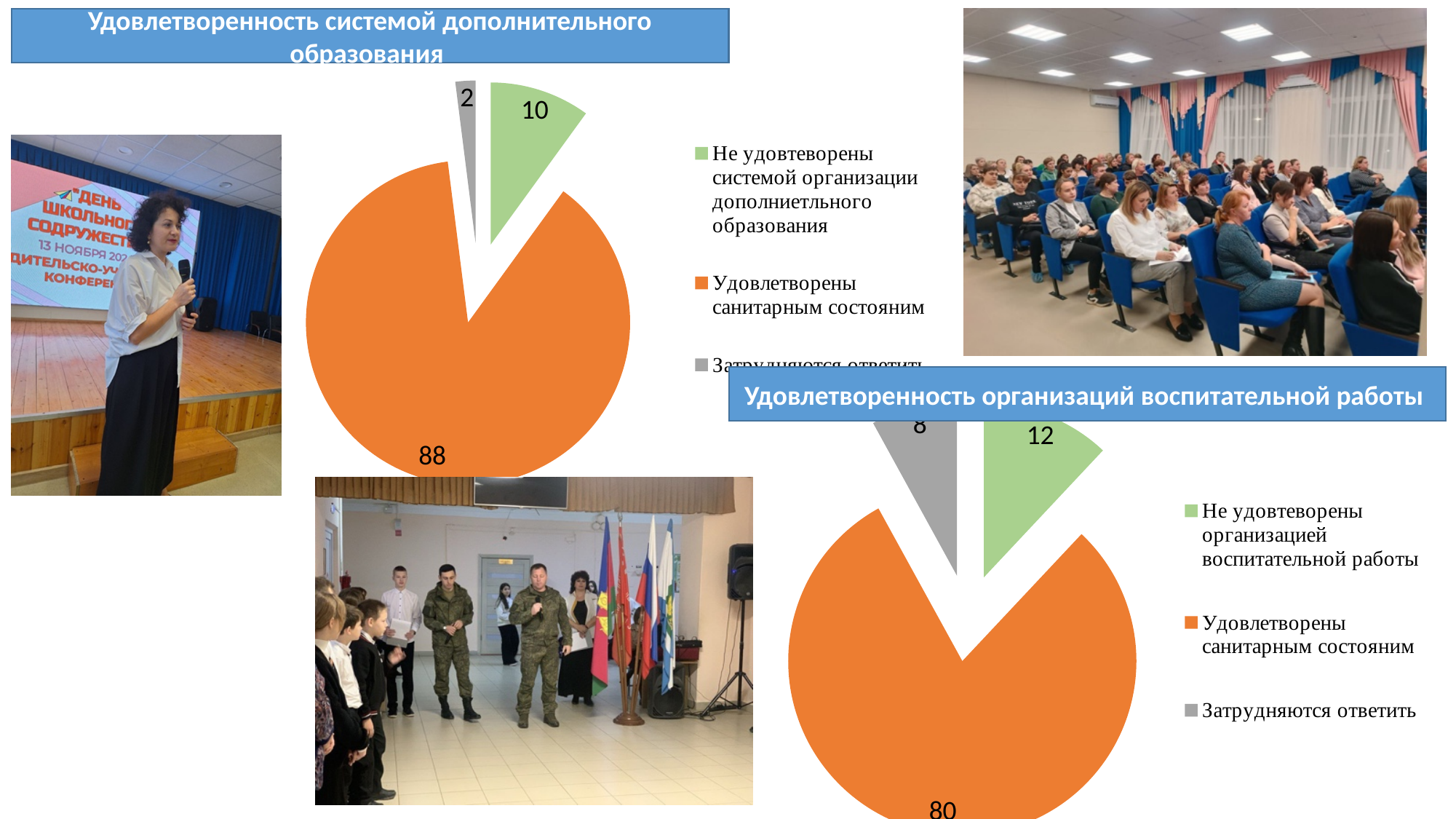
In the chart titled 'Удовлетворенность системой дополнительного образования', what is the difference between the values for 'Удовлетворены санитарным состояним' and 'Не удовтеворены системой организации дополниетльного образования'? 78 What type of chart is used for 'Удовлетворенность организаций воспитательной работы'? Pie chart In the chart titled 'Удовлетворенность системой дополнительного образования', what value is shown for 'Не удовтеворены системой организации дополниетльного образования'? 10 In the chart titled 'Удовлетворенность системой дополнительного образования', which category has the largest slice? Удовлетворены санитарным состояним How many entries does the legend of the chart titled 'Удовлетворенность организаций воспитательной работы' list? 3 In the chart titled 'Удовлетворенность организаций воспитательной работы', which category has the smallest slice? Затрудняются ответить In the chart titled 'Удовлетворенность системой дополнительного образования', what value is shown for 'Затрудняются ответить'? 2 In the chart titled 'Удовлетворенность системой дополнительного образования', what value is shown for 'Удовлетворены санитарным состояним'? 88 In the chart titled 'Удовлетворенность организаций воспитательной работы', which is larger: the value for 'Удовлетворены санитарным состояним' or for 'Не удовтеворены организацией воспитательной работы'? Удовлетворены санитарным состояним In the chart titled 'Удовлетворенность организаций воспитательной работы', what value is shown for 'Не удовтеворены организацией воспитательной работы'? 12 In the chart titled 'Удовлетворенность организаций воспитательной работы', what value is shown for 'Удовлетворены санитарным состояним'? 80 In the chart titled 'Удовлетворенность системой дополнительного образования', which category has the smallest slice? Затрудняются ответить